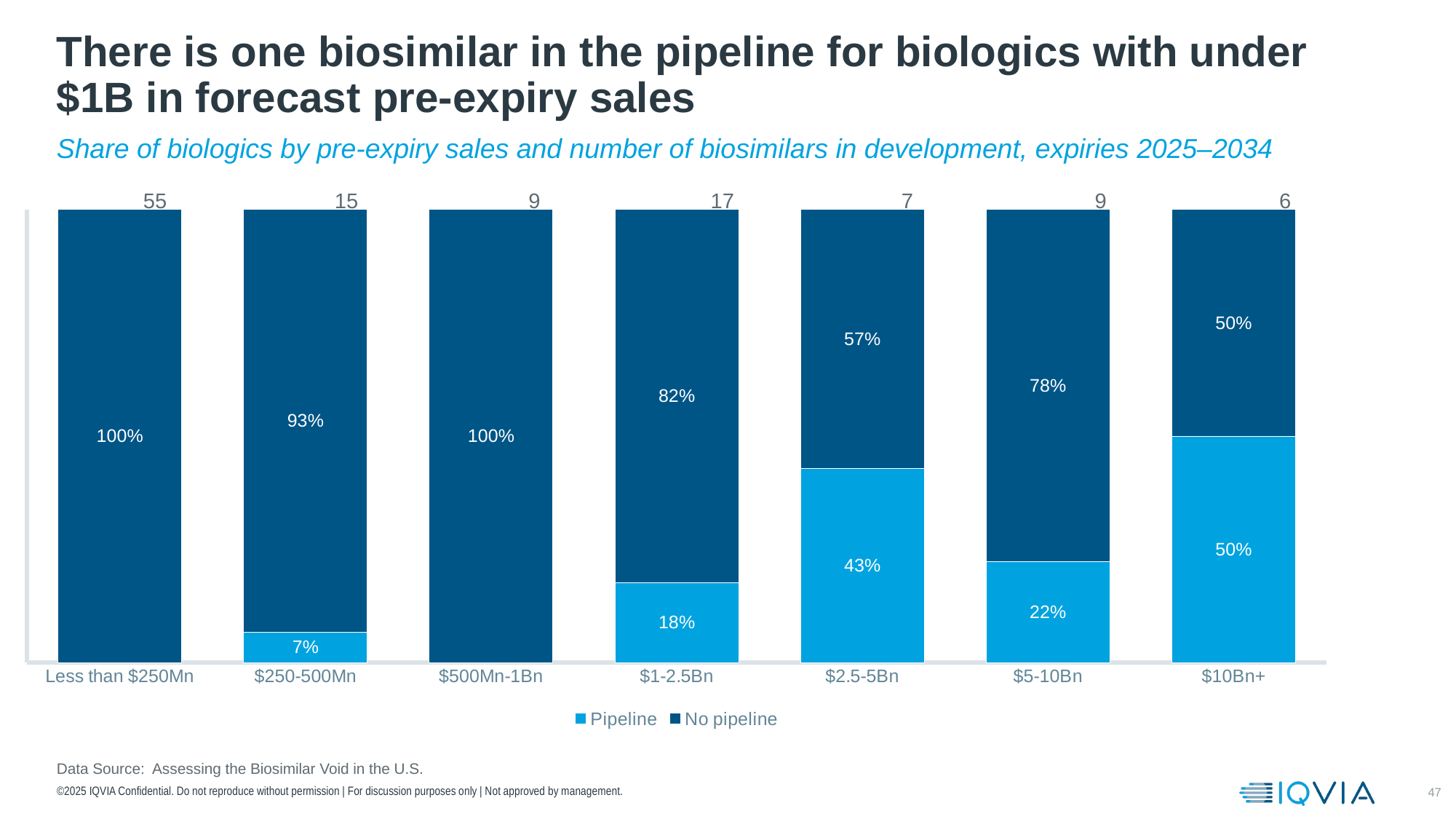
What kind of chart is shown on the slide? Stacked bar chart How many categories are shown on the x axis? 7 Which series is shown in the darker blue colour? No pipeline Among the categories with a labelled Pipeline segment, which has the lowest Pipeline share? $250-500Mn What is the Pipeline share for the $250-500Mn category? 7% What number is printed above the bar for the Less than $250Mn category? 55 Which is larger: the Pipeline share for $5-10Bn or the Pipeline share for $1-2.5Bn? $5-10Bn What is the difference between the No pipeline share for $1-2.5Bn and the No pipeline share for $2.5-5Bn? 25% What is the No pipeline share for the $5-10Bn category? 78% How many series does the legend list? 2 Which category has the highest Pipeline share? $10Bn+ What is the Pipeline share for the $2.5-5Bn category? 43%